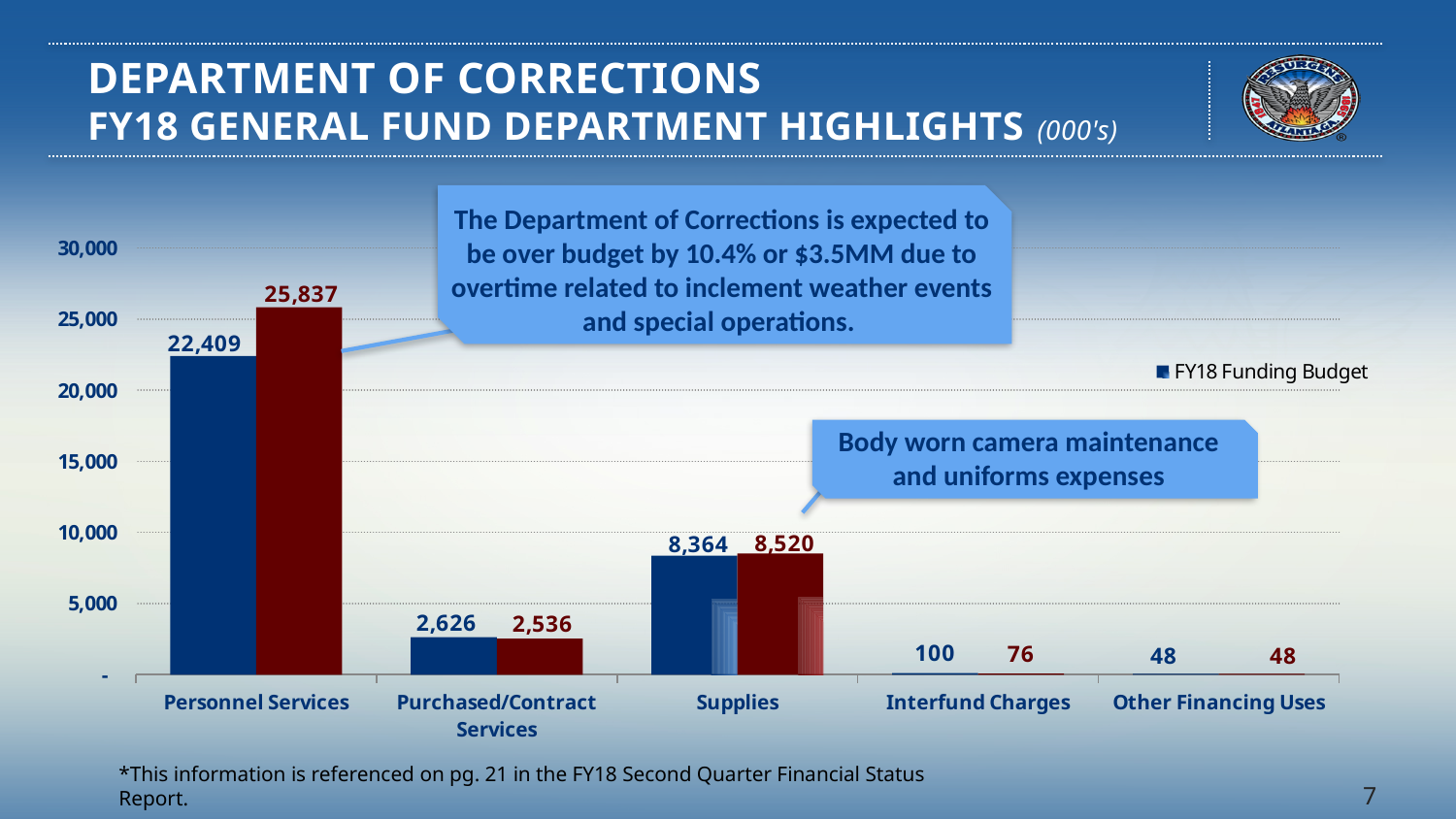
What kind of chart is shown on the slide? bar chart What is the difference between the dark red bar (8,520) and the FY18 Funding Budget bar (8,364) for Supplies? 156 What is the difference between the dark red bar (25,837) and the FY18 Funding Budget bar (22,409) for Personnel Services? 3,428 How many categories are shown on the x axis of the chart? 5 Which category has the lowest FY18 Funding Budget? Other Financing Uses What value is shown on the dark red bar for Personnel Services? 25,837 Which category has the highest FY18 Funding Budget? Personnel Services For Purchased/Contract Services, which is larger: the FY18 Funding Budget bar or the dark red bar? FY18 Funding Budget bar Is the FY18 Funding Budget value for Personnel Services greater or less than 20,000? greater What is the FY18 Funding Budget value for Personnel Services? 22,409 What is the FY18 Funding Budget value for Interfund Charges? 100 What is the FY18 Funding Budget value for Supplies? 8,364